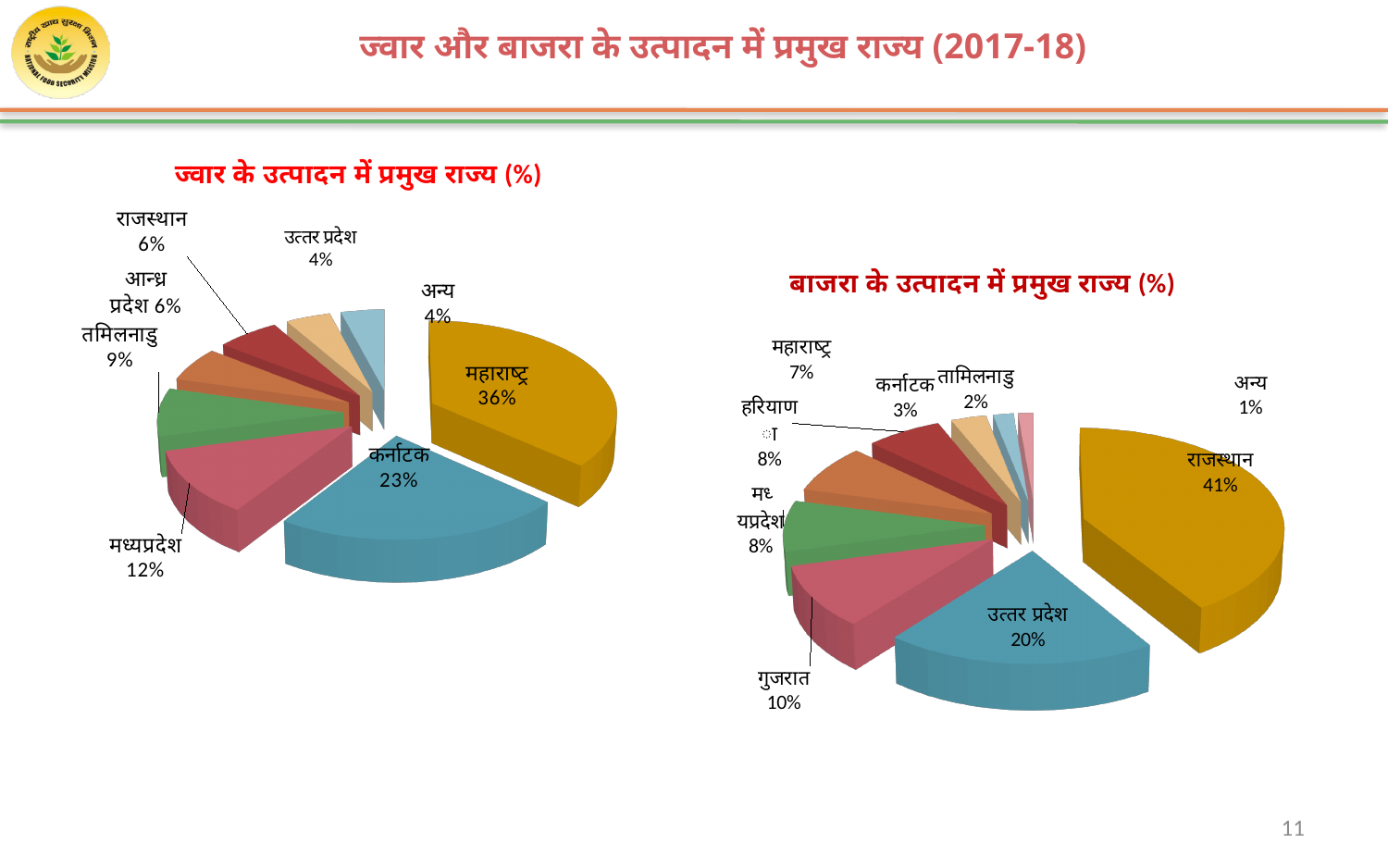
In the ज्वार (jowar) pie chart on the left, how many slices does the pie have? 8 In the ज्वार (jowar) pie chart on the left, what share does कर्नाटक (Karnataka) hold? 23% In the बाजरा (bajra) pie chart on the right, what share does राजस्थान (Rajasthan) hold? 41% What type of chart is used for both charts on the slide? Pie chart In the ज्वार (jowar) pie chart on the left, what share does महाराष्ट्र (Maharashtra) hold? 36% What is the title of the chart on the right? बाजरा के उत्पादन में प्रमुख राज्य (%) In the बाजरा (bajra) pie chart on the right, what share does गुजरात (Gujarat) hold? 10% In the बाजरा (bajra) pie chart on the right, which category has the smallest share? अन्य (Others) In the बाजरा (bajra) pie chart on the right, which is larger: the share of उत्तर प्रदेश (Uttar Pradesh) or गुजरात (Gujarat)? उत्तर प्रदेश (Uttar Pradesh) In the ज्वार (jowar) pie chart on the left, what is the difference between the shares of महाराष्ट्र (Maharashtra) and कर्नाटक (Karnataka)? 13 percentage points In the बाजरा (bajra) pie chart on the right, how many slices does the pie have? 9 In the ज्वार (jowar) pie chart on the left, which state has the largest share? महाराष्ट्र (Maharashtra)